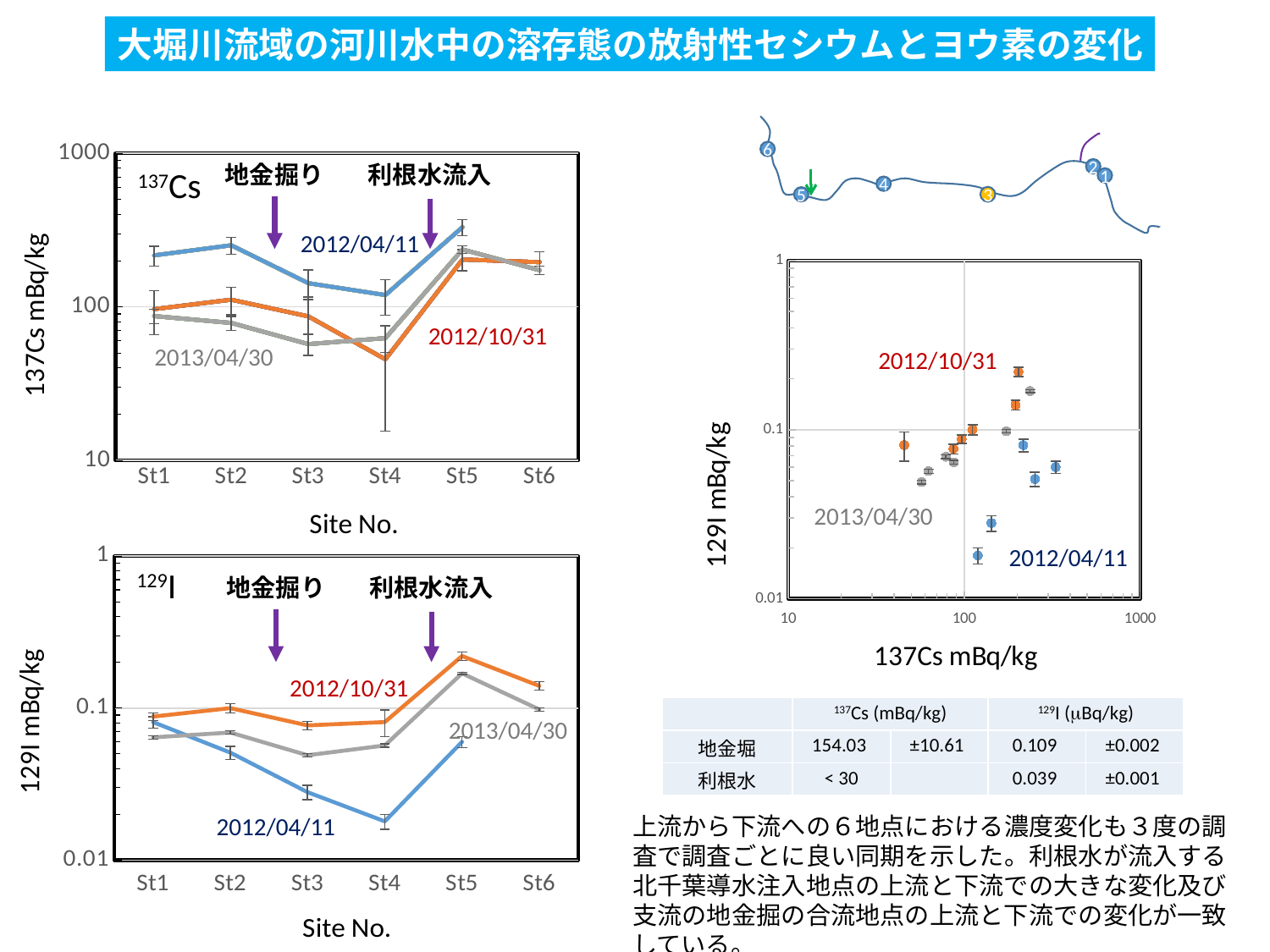
In the top-left 137Cs chart, how many dated series are plotted? 3 What is the x-axis label of the scatter chart on the right side of the slide? 137Cs mBq/kg In the bottom-left 129I chart, is the 2012/04/11 value at St4 greater or less than 0.1? less In the bottom-left 129I chart, at which site is the 2012/10/31 series highest? St5 In the top-left 137Cs chart, is the 2012/10/31 value at St4 greater or less than 100? less In the top-left 137Cs chart, is the 2012/04/11 value at St1 greater or less than 100? greater In the top-left 137Cs chart, at St4, which series has the larger value: 2012/04/11 or 2012/10/31? 2012/04/11 In the top-left 137Cs chart, how many sites are shown on the x axis? 6 In the top-left 137Cs chart, at which site is the 2012/04/11 series highest? St5 In the bottom-left 129I chart, does the 2012/04/11 series rise or fall from St1 to St4? fall What kind of chart is the top-left 137Cs chart? line chart In the top-left 137Cs chart, at which site is the 2012/10/31 series lowest? St4